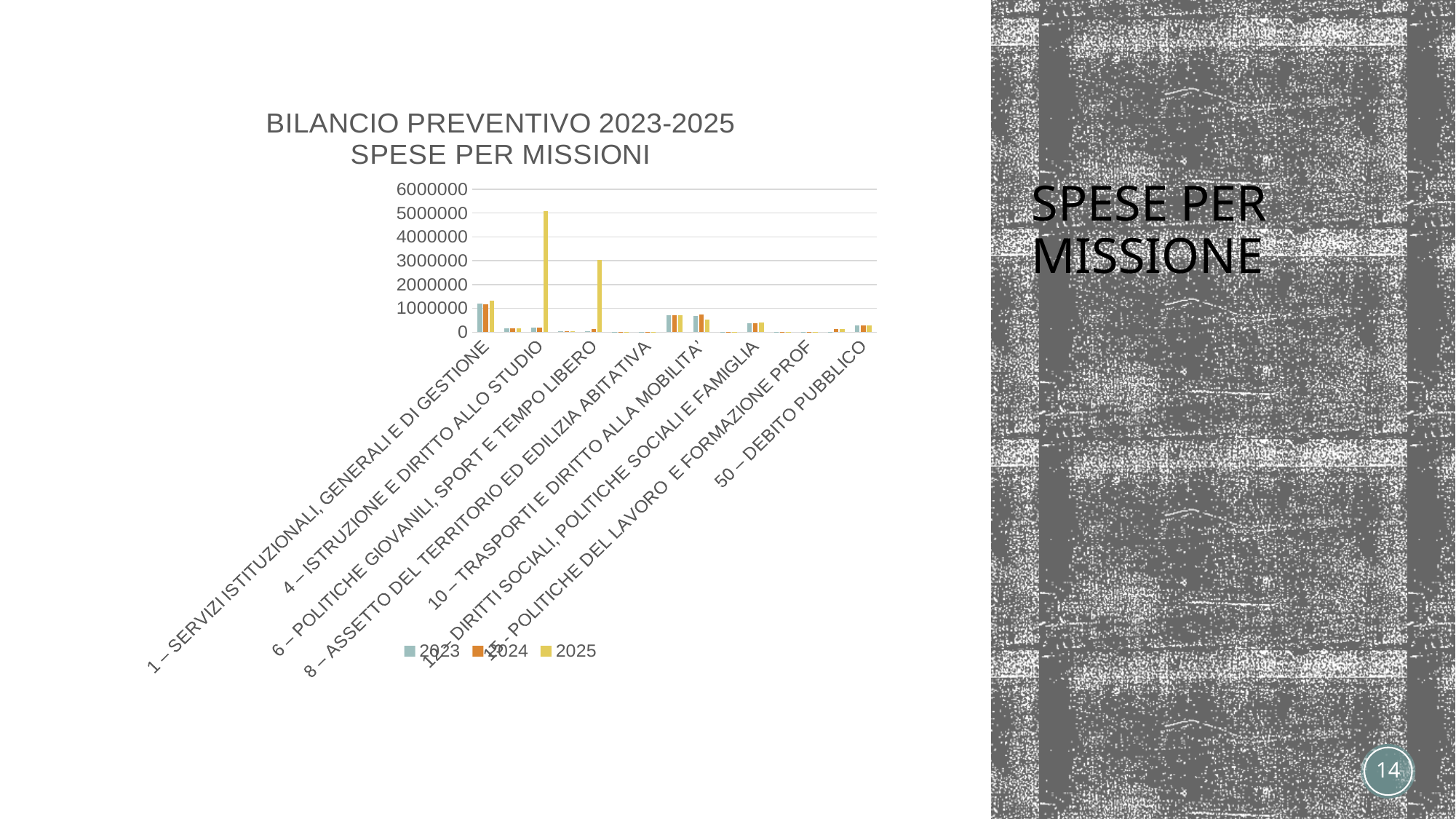
Is the 2025 value for '50 – DEBITO PUBBLICO' greater or less than 1000000? less Which series contains the tallest bar in the chart? 2025 For '1 – SERVIZI ISTITUZIONALI, GENERALI E DI GESTIONE', which series has the larger value, 2024 or 2025? 2025 What kind of chart is shown on the slide? bar chart What are the series listed in the legend? 2023, 2024, 2025 What is the title of the chart? BILANCIO PREVENTIVO 2023-2025 SPESE PER MISSIONI Is the 2024 value for '1 – SERVIZI ISTITUZIONALI, GENERALI E DI GESTIONE' greater or less than 2000000? less Is the tallest bar in the chart greater or less than 4000000? greater How many series does the legend list? 3